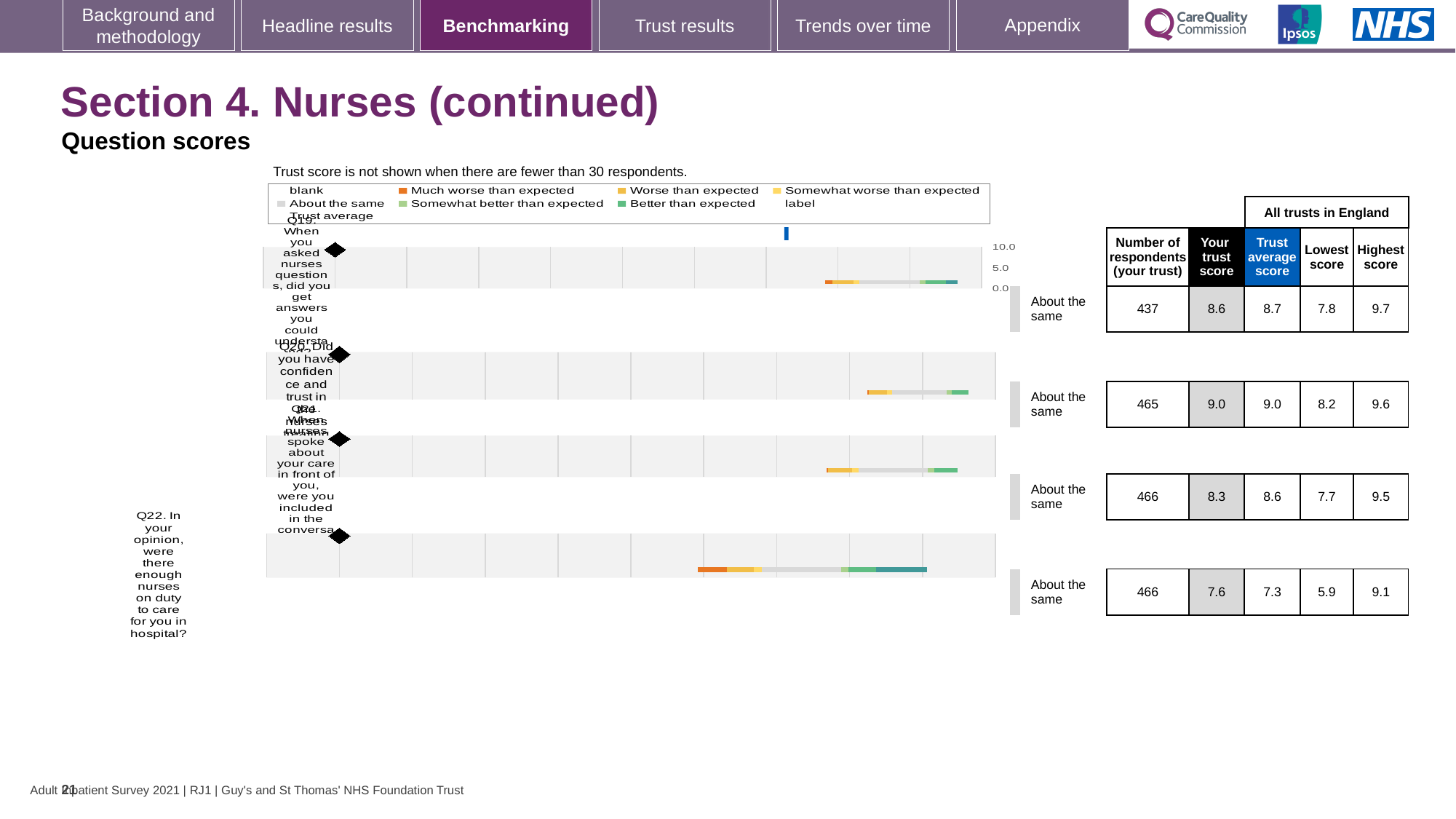
What is the trust score for Q22 (enough nurses on duty) shown in the 'Your trust score' column? 7.6 What kind of chart is used to show the question scores on this slide? bar chart What is the number of respondents for Q19? 437 Which question has the lowest 'Your trust score'? Q22 How many questions (categories) are plotted in the chart? 4 For Q22, which is larger: the trust's own score or the trust average score? Your trust score (7.6) What benchmark category is shown for all four questions? About the same What is the highest score across all trusts in England for Q20? 9.6 What is the trust average score for Q21? 8.6 Which question has the highest 'Your trust score'? Q20 What is the difference between the highest score and the lowest score for Q19? 1.9